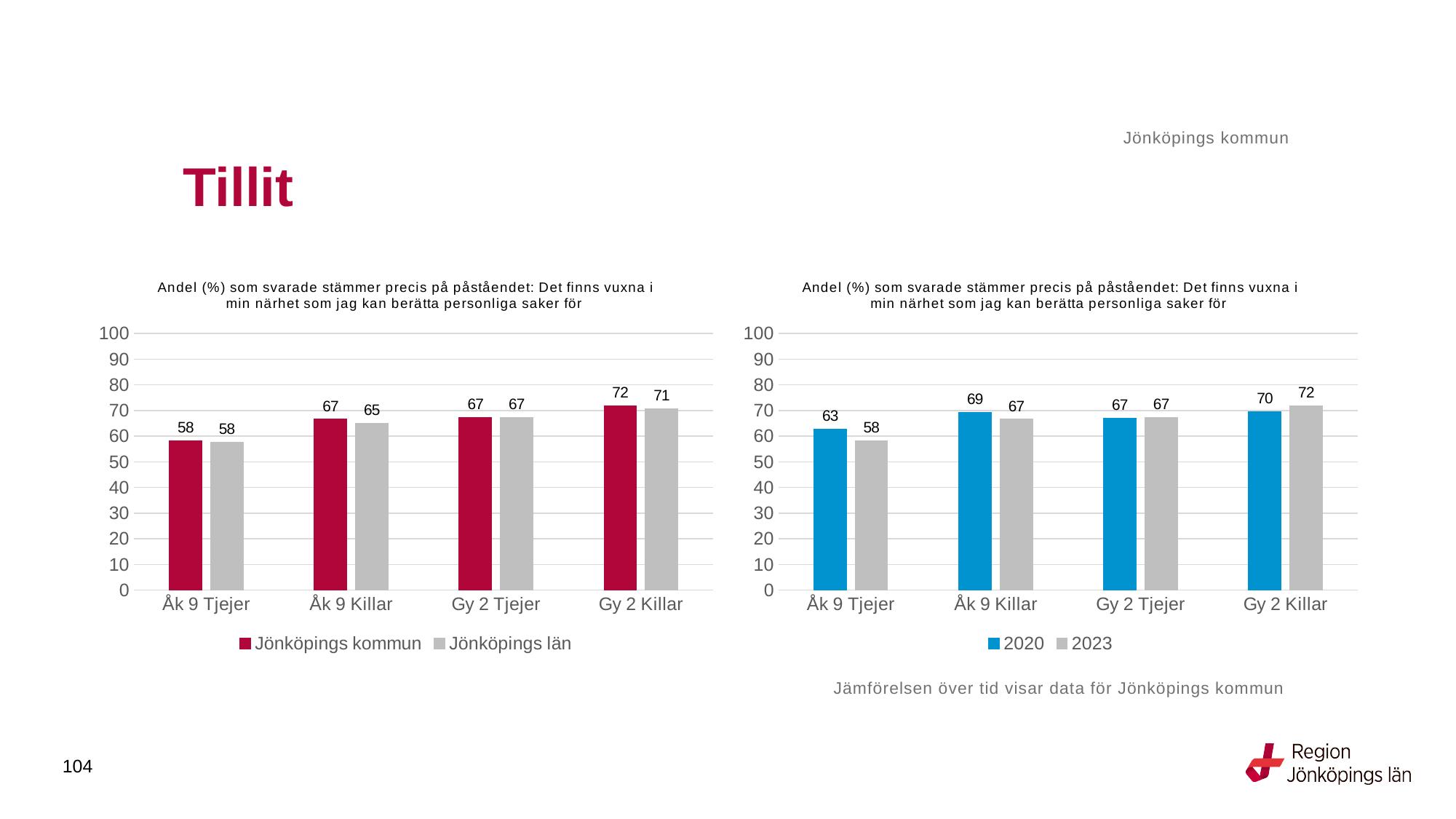
In the right chart, which is larger for Åk 9 Tjejer, 2020 or 2023? 2020 In the left chart, which category has the highest value for Jönköpings kommun? Gy 2 Killar In the right chart, what is the value for 2020 for Åk 9 Tjejer? 63 In the left chart, what is the value for Jönköpings län for Åk 9 Killar? 65 In the left chart, what is the value for Jönköpings kommun for Åk 9 Tjejer? 58 In the left chart, how many series does the legend list? 2 In the left chart, what is the difference between Jönköpings kommun and Jönköpings län for Åk 9 Killar? 2 In the right chart, what is the value for 2023 for Gy 2 Killar? 72 What kind of chart is the right chart? Bar chart In the right chart, how many categories are shown on the x axis? 4 In the right chart, what is the difference between 2020 and 2023 for Åk 9 Tjejer? 5 In the left chart, which category has the lowest value for Jönköpings län? Åk 9 Tjejer